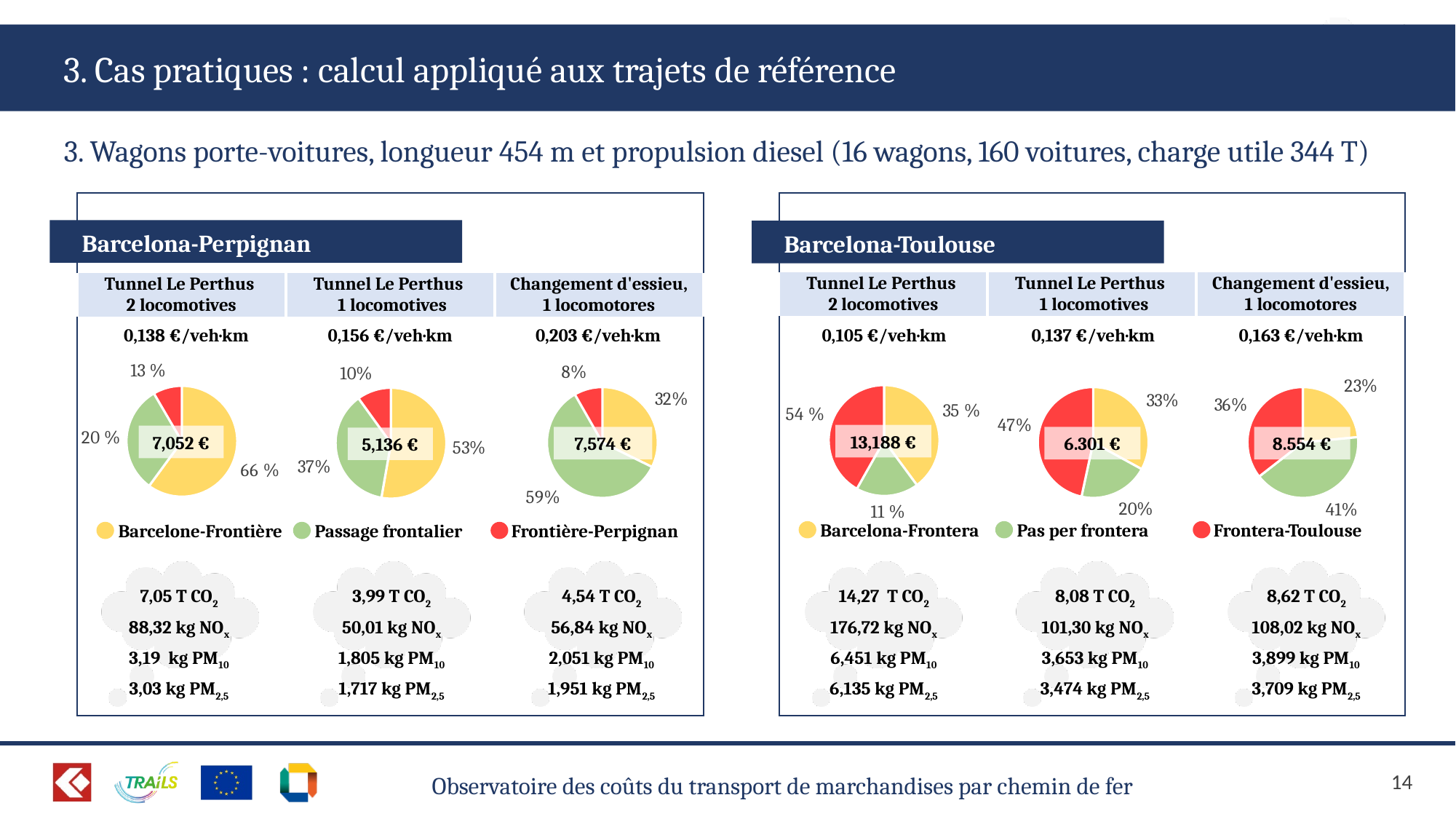
In the Barcelona-Toulouse panel, which segment is the smallest in the 'Tunnel Le Perthus 2 locomotives' pie chart? Pas per frontera In the Barcelona-Toulouse panel, which segment is the largest in the 'Tunnel Le Perthus 1 locomotives' pie chart? Frontera-Toulouse How many segments does each pie chart on the slide have? 3 In the Barcelona-Perpignan panel, which segment is the smallest in the 'Changement d'essieu, 1 locomotores' pie chart? Frontière-Perpignan In the Barcelona-Perpignan panel, what share of the 'Tunnel Le Perthus 1 locomotives' pie chart is Passage frontalier? 37% In the Barcelona-Perpignan panel, which segment is the largest in the 'Changement d'essieu, 1 locomotores' pie chart? Passage frontalier In the Barcelona-Toulouse panel, what share of the 'Tunnel Le Perthus 2 locomotives' pie chart is Frontera-Toulouse? 54 % In the Barcelona-Perpignan panel, what share of the 'Tunnel Le Perthus 2 locomotives' pie chart is Barcelone-Frontière? 66 % What type of chart is used to show the cost breakdown for each scenario on this slide? Pie chart In the Barcelona-Toulouse panel, what is the difference between the Frontera-Toulouse and Barcelona-Frontera shares in the 'Tunnel Le Perthus 1 locomotives' pie chart? 14 percentage points How many entries does the legend of the Barcelona-Toulouse panel list? 3